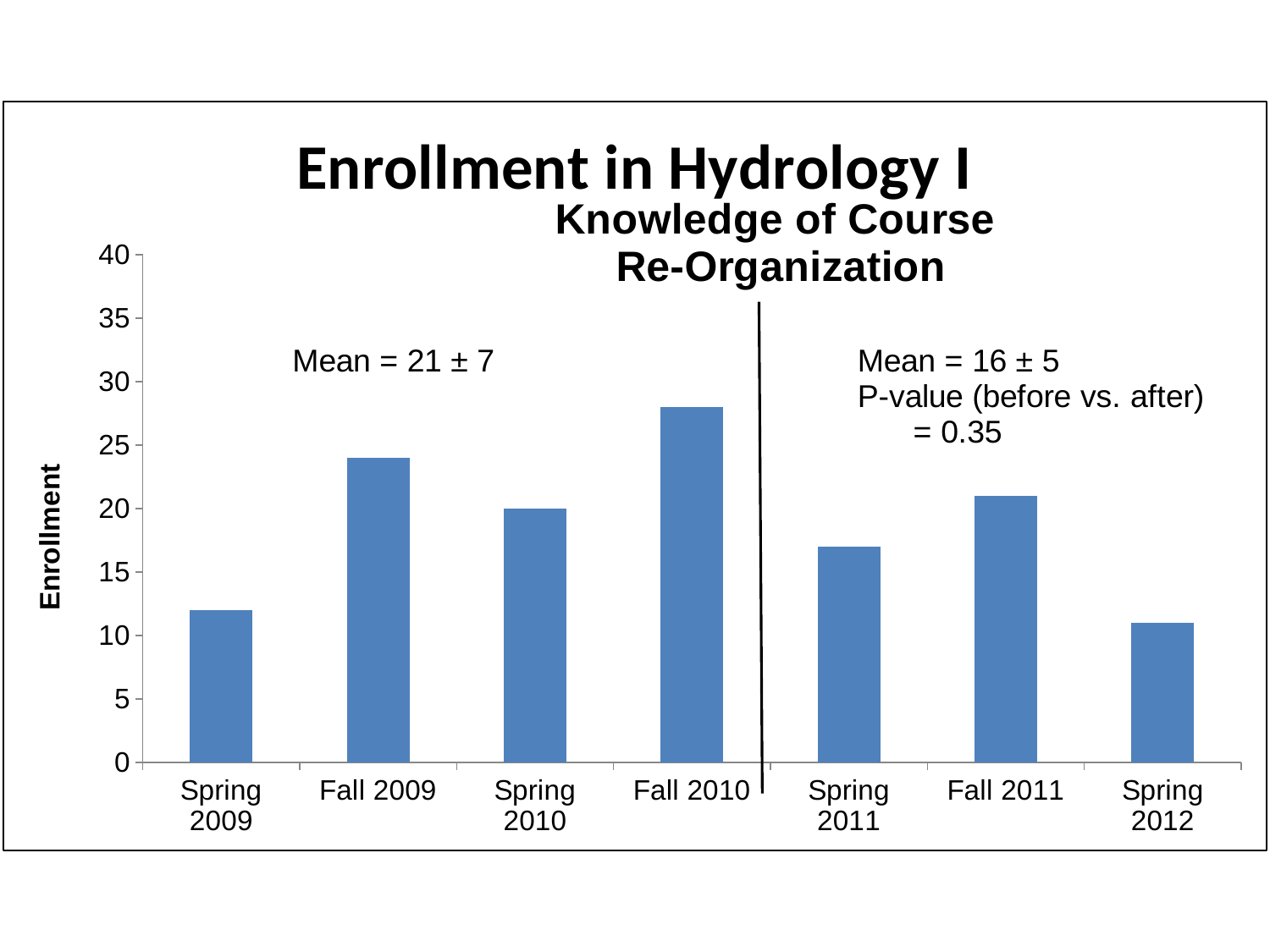
Which has the larger enrollment, Fall 2009 or Spring 2010? Fall 2009 What is the title of the chart? Enrollment in Hydrology I Is the enrollment for Fall 2010 greater or less than 25? greater What kind of chart is shown on the slide? bar chart Is the enrollment for Spring 2009 greater or less than 15? less Which has the larger enrollment, Fall 2010 or Fall 2011? Fall 2010 Is the enrollment for Spring 2012 greater or less than 15? less How many semesters (categories) are plotted on the x axis? 7 Which semester has the highest enrollment? Fall 2010 What mean enrollment is annotated for the semesters before the course re-organization? 21 ± 7